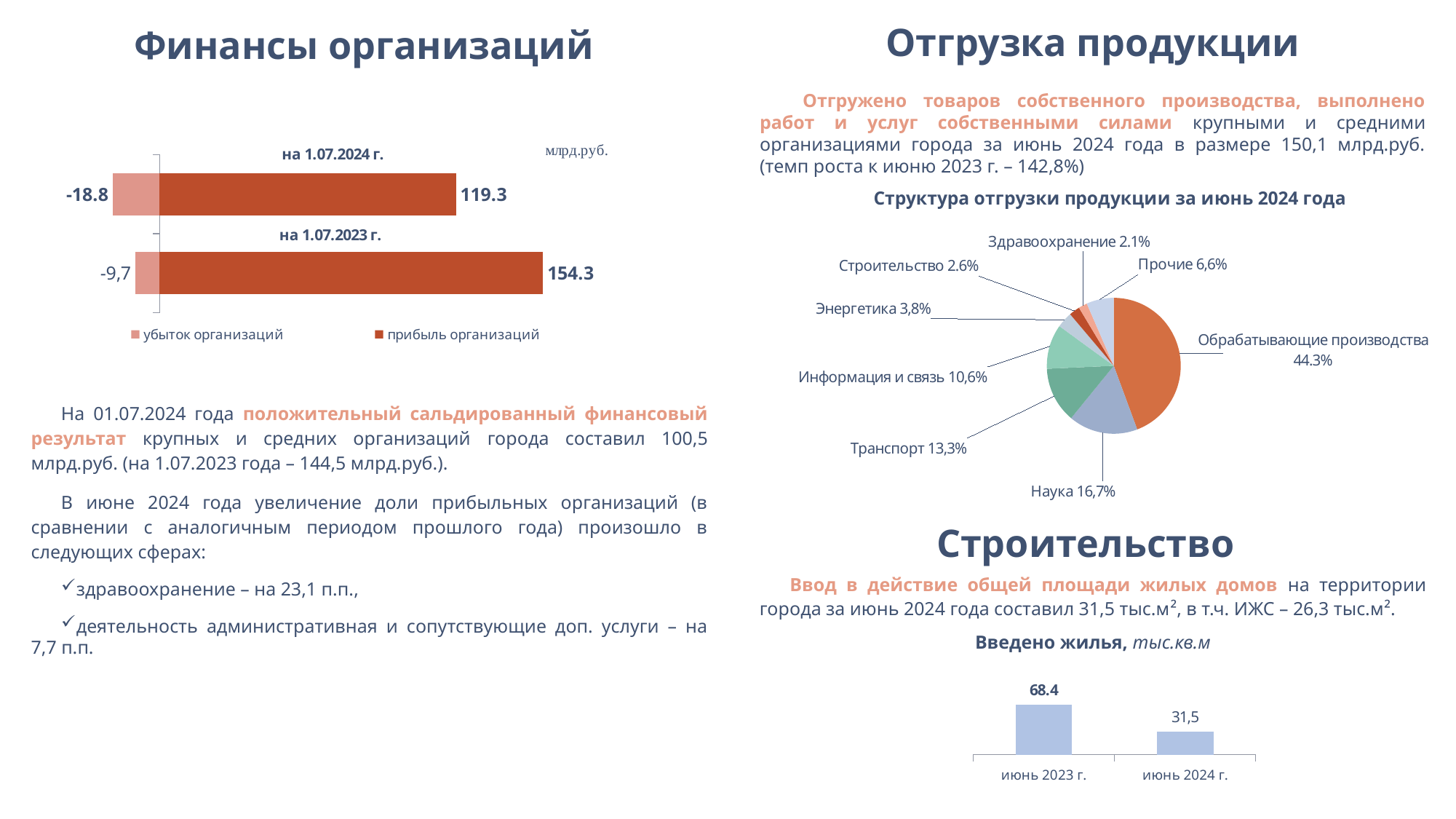
In the 'Финансы организаций' chart, what is the value of убыток организаций на 1.07.2023 г.? -9,7 In the 'Структура отгрузки продукции за июнь 2024 года' chart, which category has the smallest share? Здравоохранение In the 'Финансы организаций' chart, what unit is shown for the values? млрд.руб. What kind of chart is 'Структура отгрузки продукции за июнь 2024 года'? pie chart In the 'Финансы организаций' chart, how many series does the legend list? 2 In the 'Структура отгрузки продукции за июнь 2024 года' chart, which is larger: Транспорт or Наука? Наука In the 'Введено жилья, тыс.кв.м' chart, what is the value for июнь 2024 г.? 31,5 In the 'Введено жилья, тыс.кв.м' chart, do the values rise or fall from июнь 2023 г. to июнь 2024 г.? fall In the 'Финансы организаций' chart, by how much does прибыль организаций на 1.07.2023 г. exceed прибыль организаций на 1.07.2024 г.? 35.0 In the 'Структура отгрузки продукции за июнь 2024 года' chart, how many slices are there? 8 In the 'Финансы организаций' chart, what is the value of прибыль организаций на 1.07.2024 г.? 119.3 In the 'Структура отгрузки продукции за июнь 2024 года' chart, what share does Обрабатывающие производства have? 44.3%